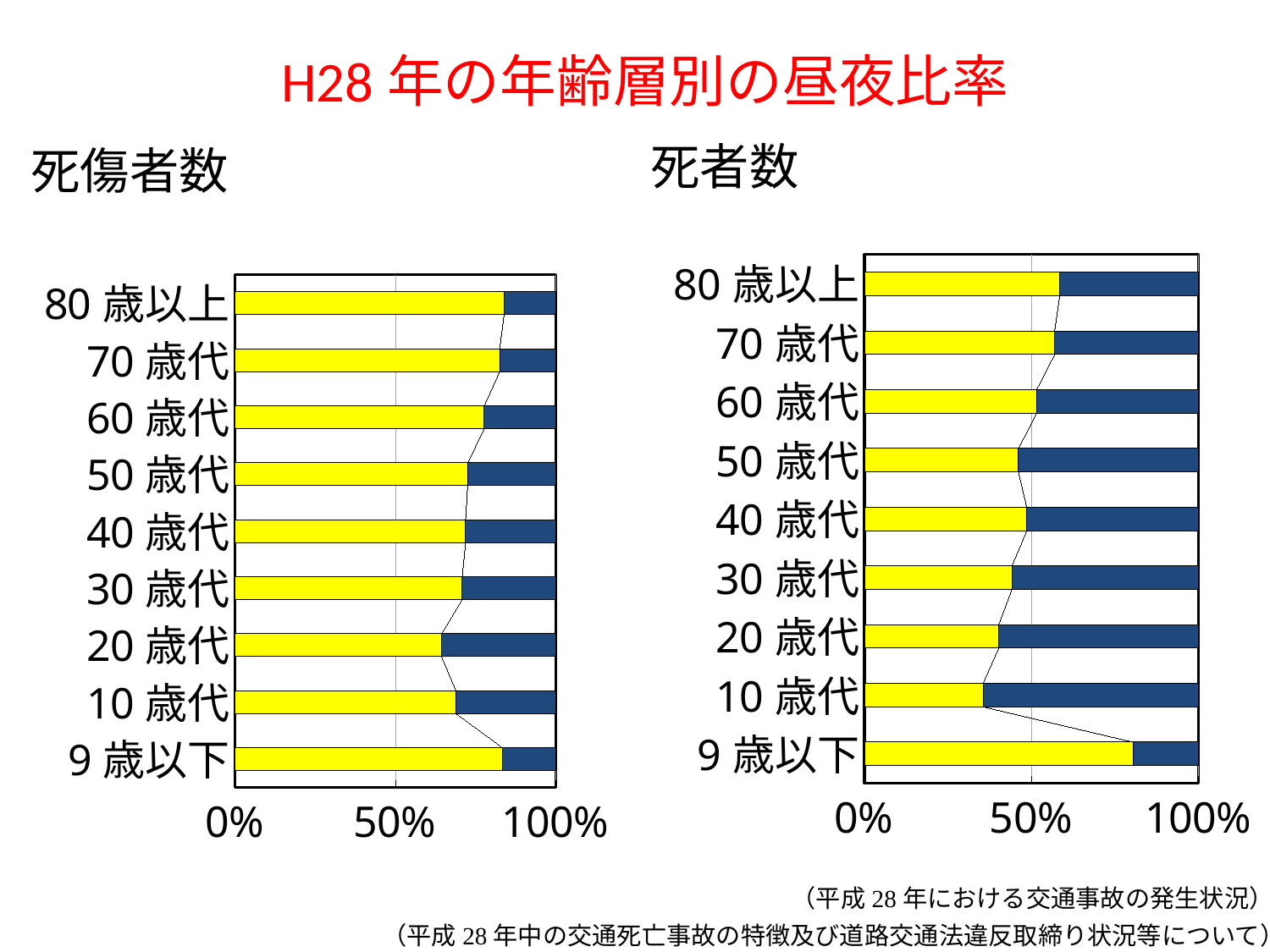
In the 死者数 chart, which age category has the smallest yellow segment? 10歳代 In the 死者数 chart, is the yellow segment for 9歳以下 greater or less than 50%? greater In the 死傷者数 chart, which has the larger yellow segment, 80歳以上 or 20歳代? 80歳以上 In the 死者数 chart, is the yellow segment for 20歳代 greater or less than 50%? less In the 死者数 chart, is the yellow segment for 10歳代 greater or less than 50%? less How many age categories are shown in the 死者数 chart? 9 What is the title of the slide's charts as a whole? H28年の年齢層別の昼夜比率 In the 死者数 chart, which age category has the largest yellow segment? 9歳以下 In the 死者数 chart, which has the larger yellow segment, 9歳以下 or 10歳代? 9歳以下 How many age categories are shown in the 死傷者数 chart? 9 What kind of chart is the 死傷者数 chart? bar chart